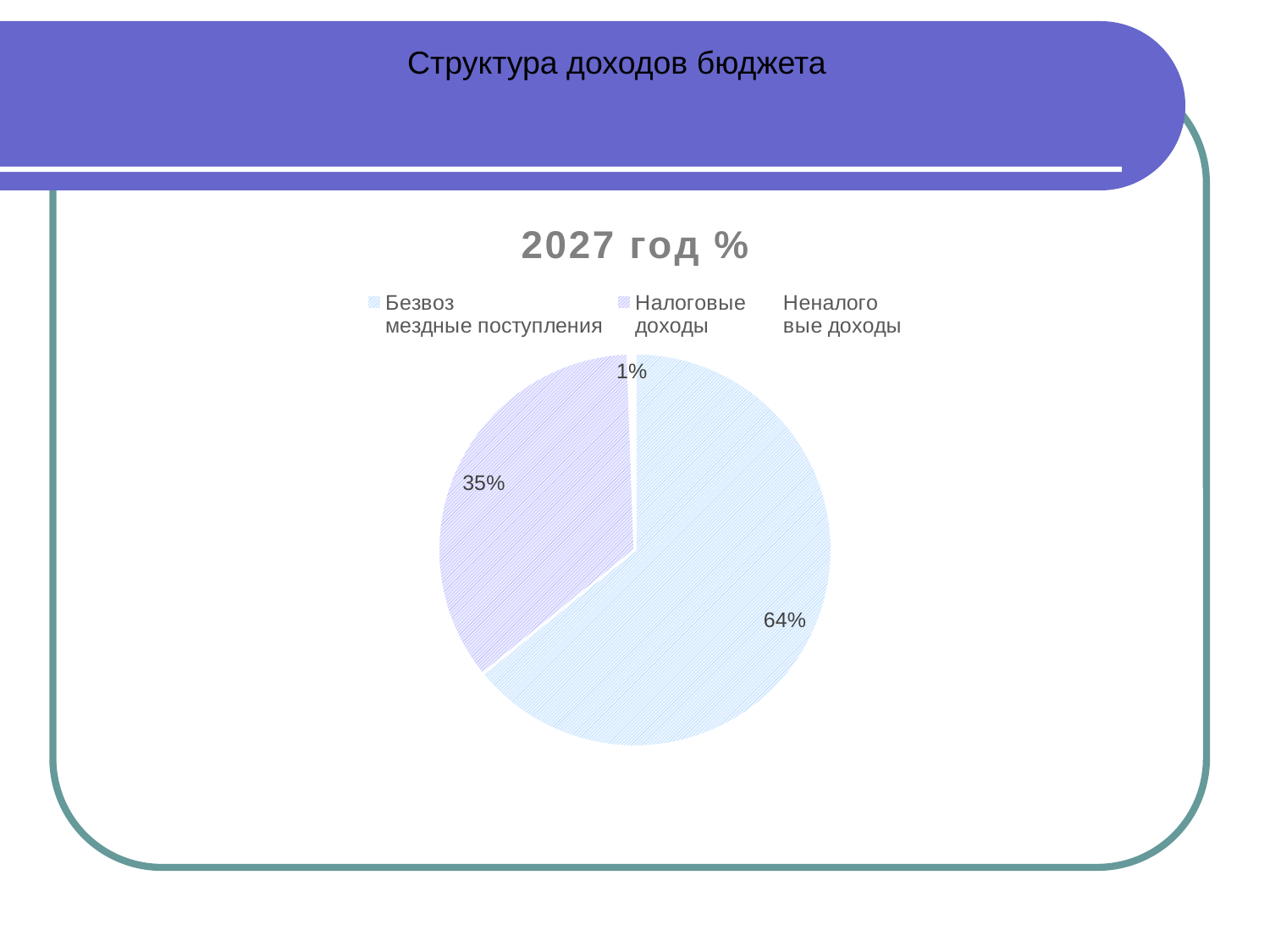
How many slices does the pie chart have? 3 What is the difference in percentage points between Налоговые доходы and Неналоговые доходы? 34 Which is larger, the slice for Налоговые доходы or the slice for Неналоговые доходы? Налоговые доходы What share of the pie is Неналоговые доходы? 1% Which category has the largest slice of the pie? Безвозмездные поступления What is the difference in percentage points between Безвозмездные поступления and Налоговые доходы? 29 Which category has the smallest slice of the pie? Неналоговые доходы What kind of chart is shown on the slide? pie chart What share of the pie is Налоговые доходы? 35% What share of the pie is Безвозмездные поступления? 64% How many entries does the legend list? 3 What is the title of the chart? 2027 год %